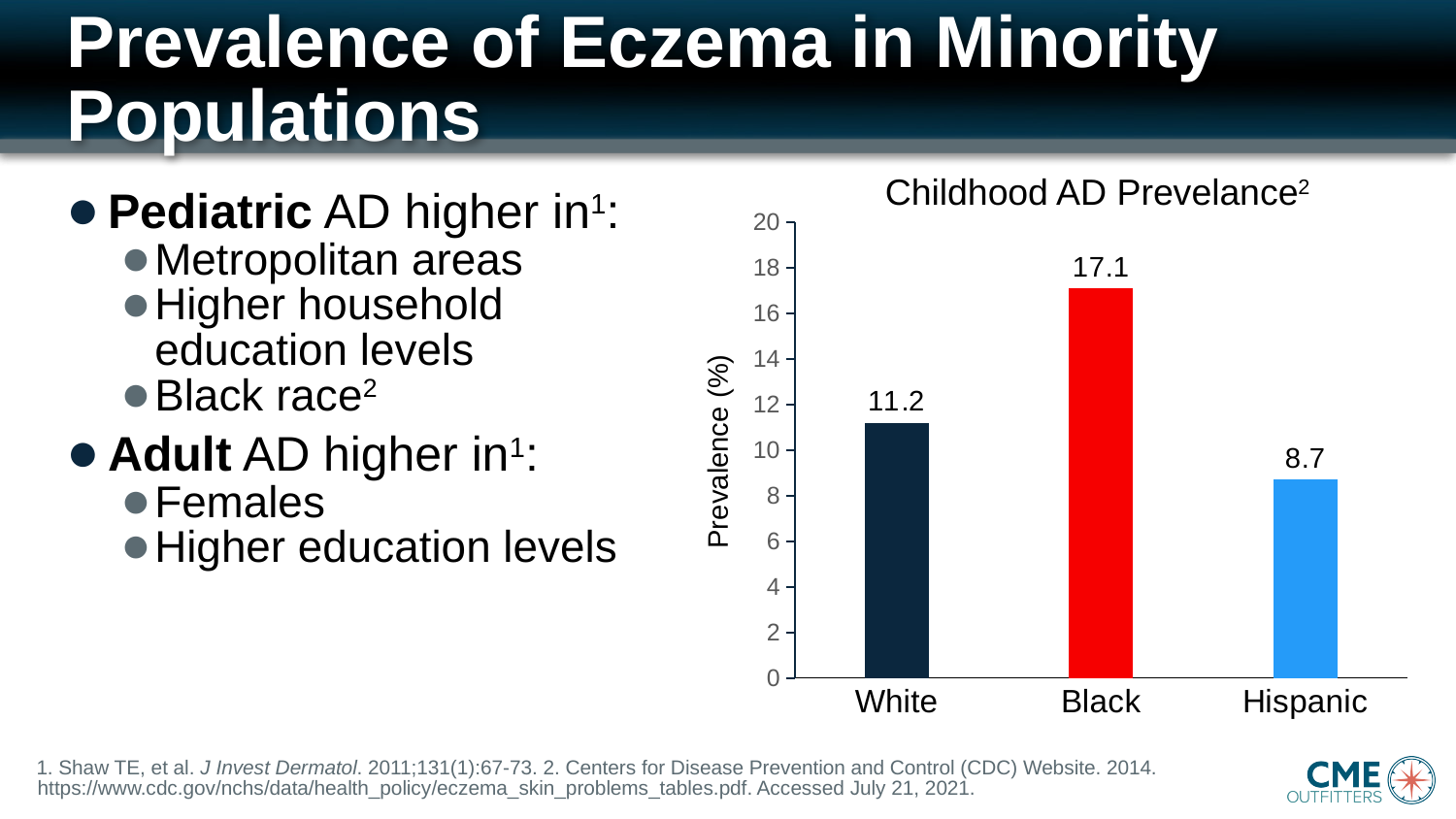
What is the childhood AD prevalence for Hispanic children? 8.7 Which group has the highest childhood AD prevalence? Black What is the label of the y axis of the chart? Prevalence (%) How many groups are shown in the chart? 3 What kind of chart is shown on the slide? Bar chart Which group has the lowest childhood AD prevalence? Hispanic What is the childhood AD prevalence for Black children? 17.1 Is the childhood AD prevalence for Black children greater or less than 16? greater Which group has a higher childhood AD prevalence, White or Hispanic? White What is the childhood AD prevalence for White children? 11.2 What is the difference in childhood AD prevalence between White and Hispanic children? 2.5 What is the difference in childhood AD prevalence between Black and White children? 5.9